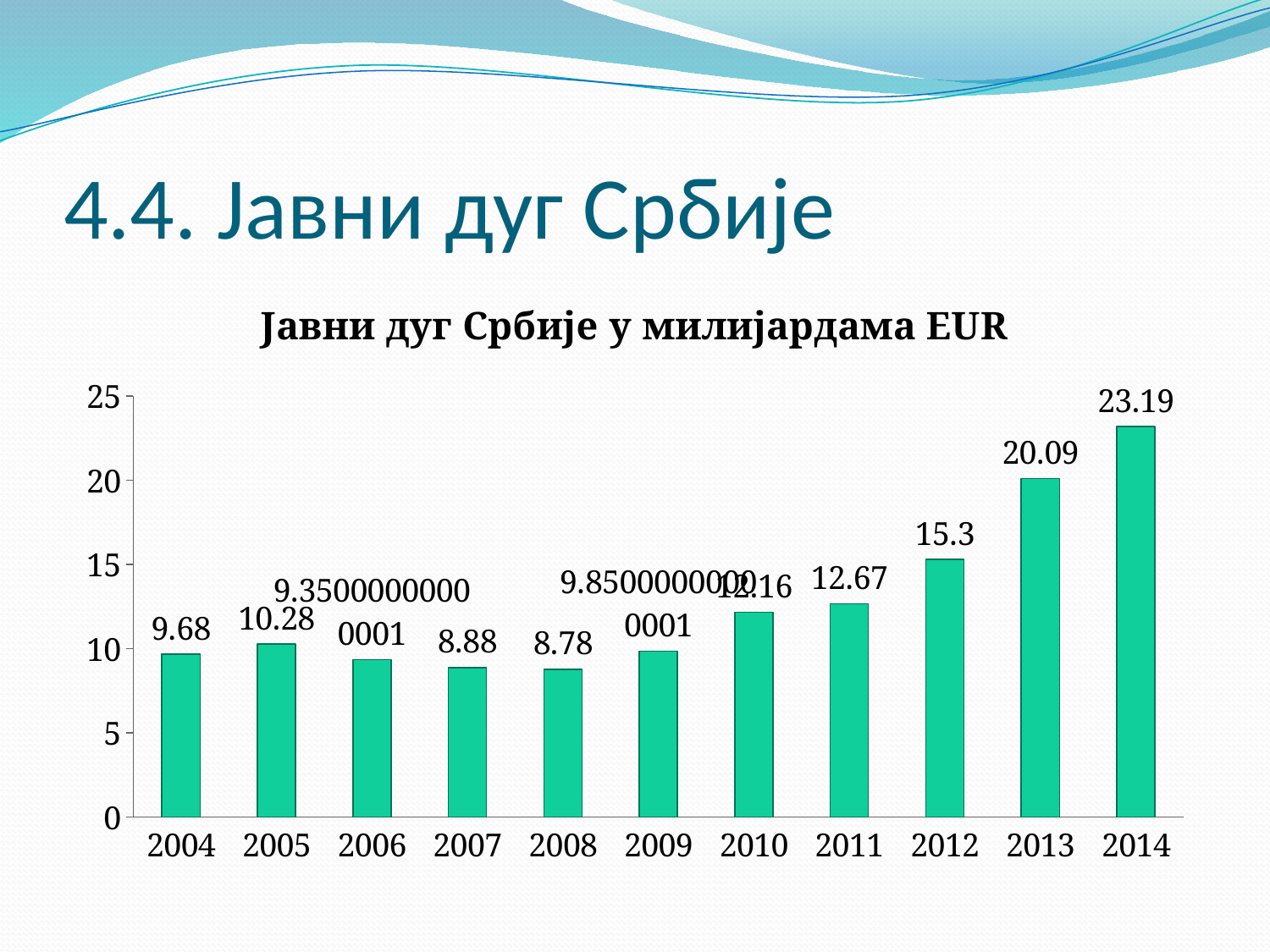
What is the difference between the values for 2014 and 2013? 3.1 Is the value for 2013 greater or less than 15? greater Which is larger, the value for 2005 or the value for 2007? 2005 What is the title of the chart? Јавни дуг Србије у милијардама EUR What kind of chart is this? bar chart What is the value for 2014? 23.19 Which year has the highest value? 2014 What is the value for 2008? 8.78 What is the value for 2012? 15.3 Which year has the lowest value? 2008 How many years are shown on the x axis? 11 What is the value for 2004? 9.68